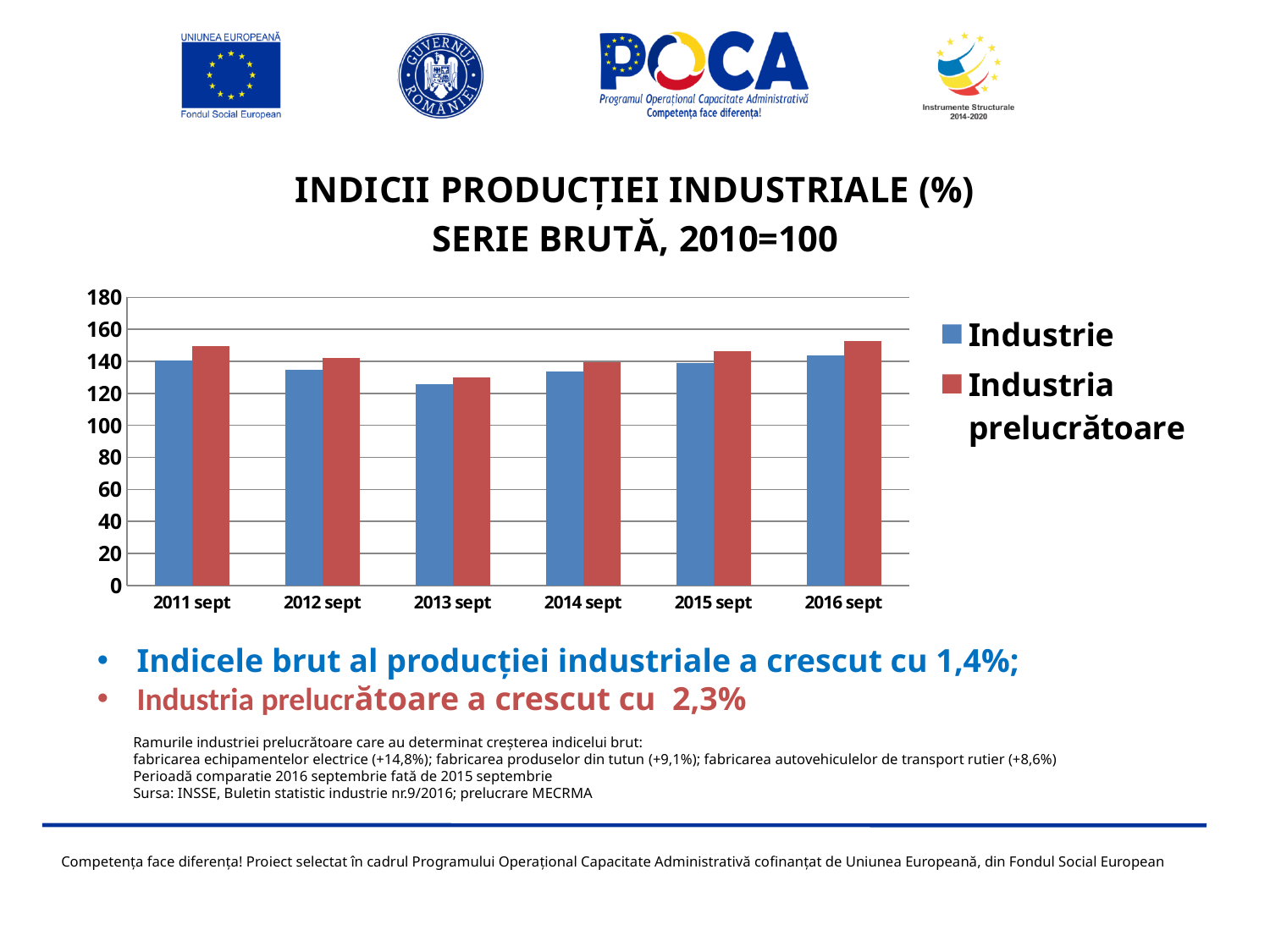
Which colour represents the Industria prelucrătoare series in the chart? red What kind of chart is shown on the slide? bar chart What base year is the index set to 100 according to the chart title? 2010 For 2011 sept, which is larger: Industrie or Industria prelucrătoare? Industria prelucrătoare How many series does the chart legend list? 2 Is the Industrie value for 2016 sept greater or less than 120? greater Is the Industria prelucrătoare value for 2011 sept greater or less than 140? greater In which period is the Industria prelucrătoare value lowest? 2013 sept Do the Industrie values rise or fall from 2013 sept to 2016 sept? rise Is the Industrie value for 2013 sept greater or less than 140? less In which period is the Industrie value lowest? 2013 sept How many time periods are shown on the x axis of the chart? 6